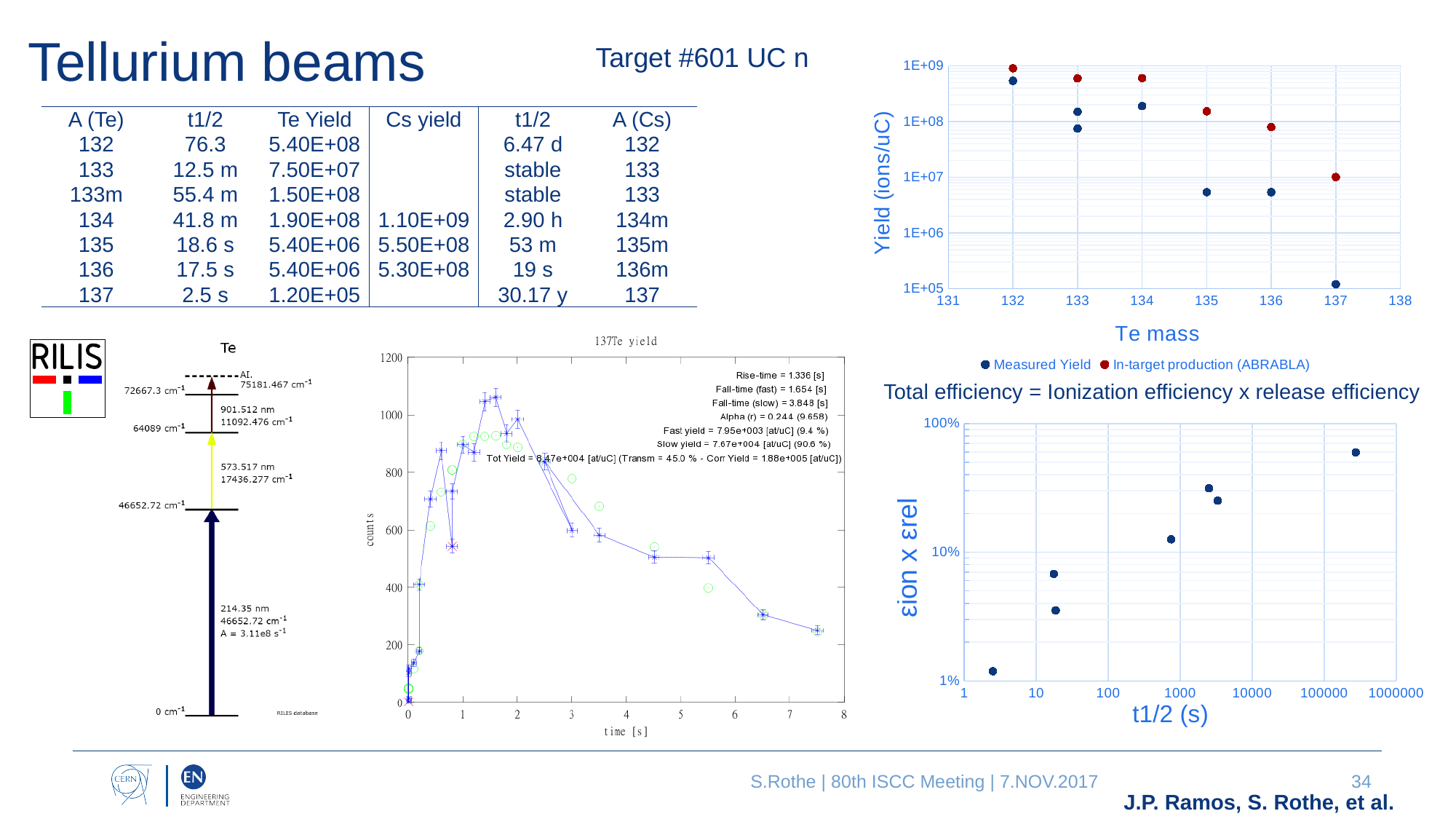
In the bottom-right chart of εion x εrel versus t1/2 (s), do the values generally rise or fall as t1/2 increases? rise In the top-right chart of Yield versus Te mass, is the Measured Yield at Te mass 137 greater or less than 1E+06? less In the bottom-right chart of εion x εrel versus t1/2 (s), is the value for the point with the longest half-life greater or less than 10%? greater In the top-right chart of Yield versus Te mass, is the Measured Yield at Te mass 135 greater or less than 1E+07? less In the top-right chart of Yield versus Te mass, how many series does the legend list? 2 In the top-right chart of Yield versus Te mass, which Te mass has the highest Measured Yield? 132 In the bottom-right chart of εion x εrel versus t1/2 (s), how many data points are plotted? 7 In the top-right chart of Yield versus Te mass, which Te mass has the lowest Measured Yield? 137 In the top-right chart of Yield versus Te mass, what kind of chart is it? scatter chart In the top-right chart of Yield versus Te mass, which is larger at Te mass 136: the Measured Yield or the In-target production (ABRABLA)? In-target production (ABRABLA)